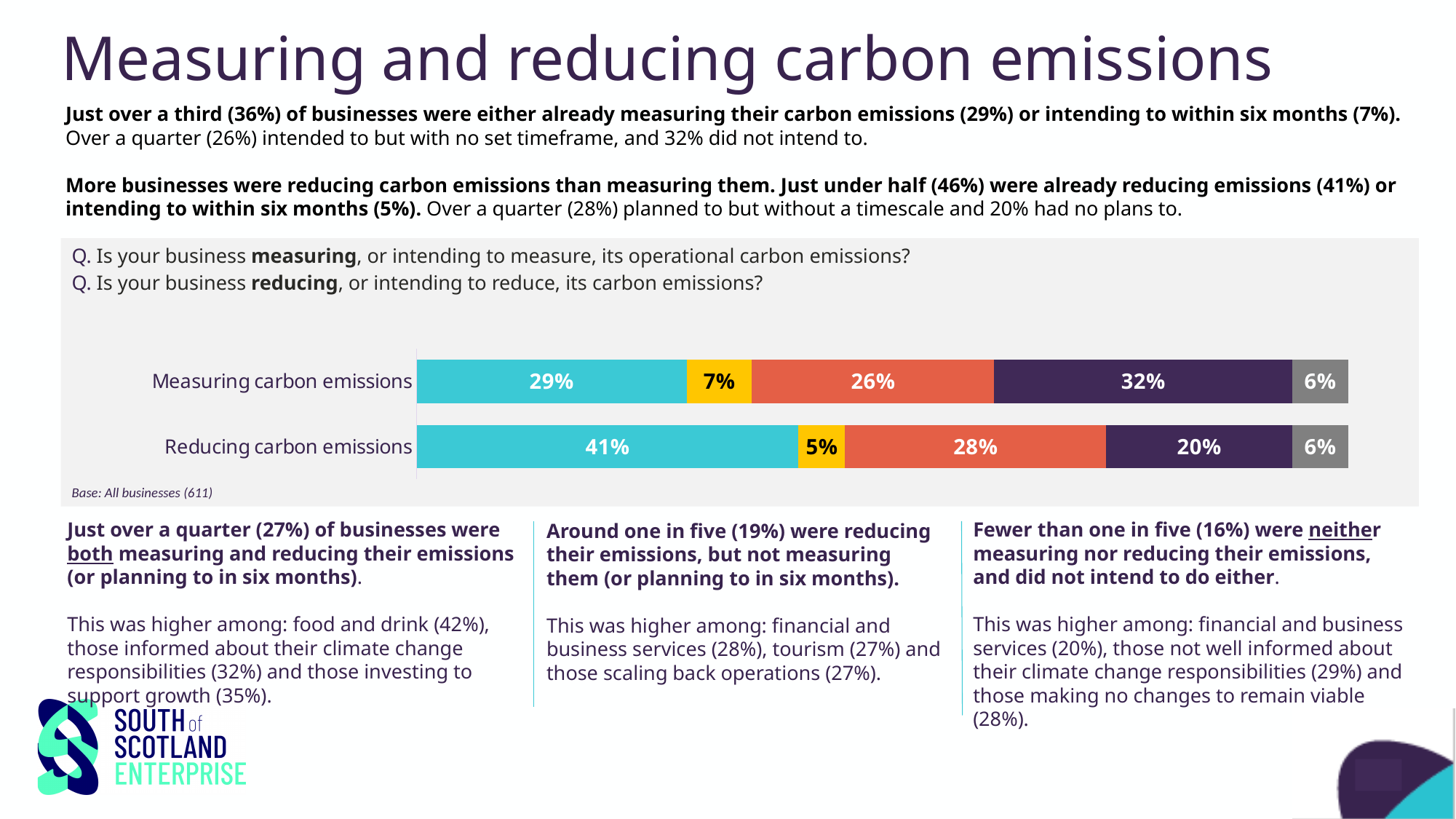
What is the difference between the teal segments of the Reducing carbon emissions bar (41%) and the Measuring carbon emissions bar (29%)? 12% Which bar has the larger teal segment, Measuring carbon emissions or Reducing carbon emissions? Reducing carbon emissions What is the value of the grey segment at the end of the Measuring carbon emissions bar? 6% What is the value of the orange segment of the Reducing carbon emissions bar? 28% What is the value of the yellow segment of the Reducing carbon emissions bar? 5% What is the value of the first (teal) segment of the Measuring carbon emissions bar? 29% What is the difference between the dark purple segments of the Measuring carbon emissions bar (32%) and the Reducing carbon emissions bar (20%)? 12% What is the value of the first (teal) segment of the Reducing carbon emissions bar? 41% What is the value of the dark purple segment of the Measuring carbon emissions bar? 32% What type of chart is shown on the slide? Stacked bar chart How many categories (bars) does the chart show? 2 How many segments make up each stacked bar in the chart? 5